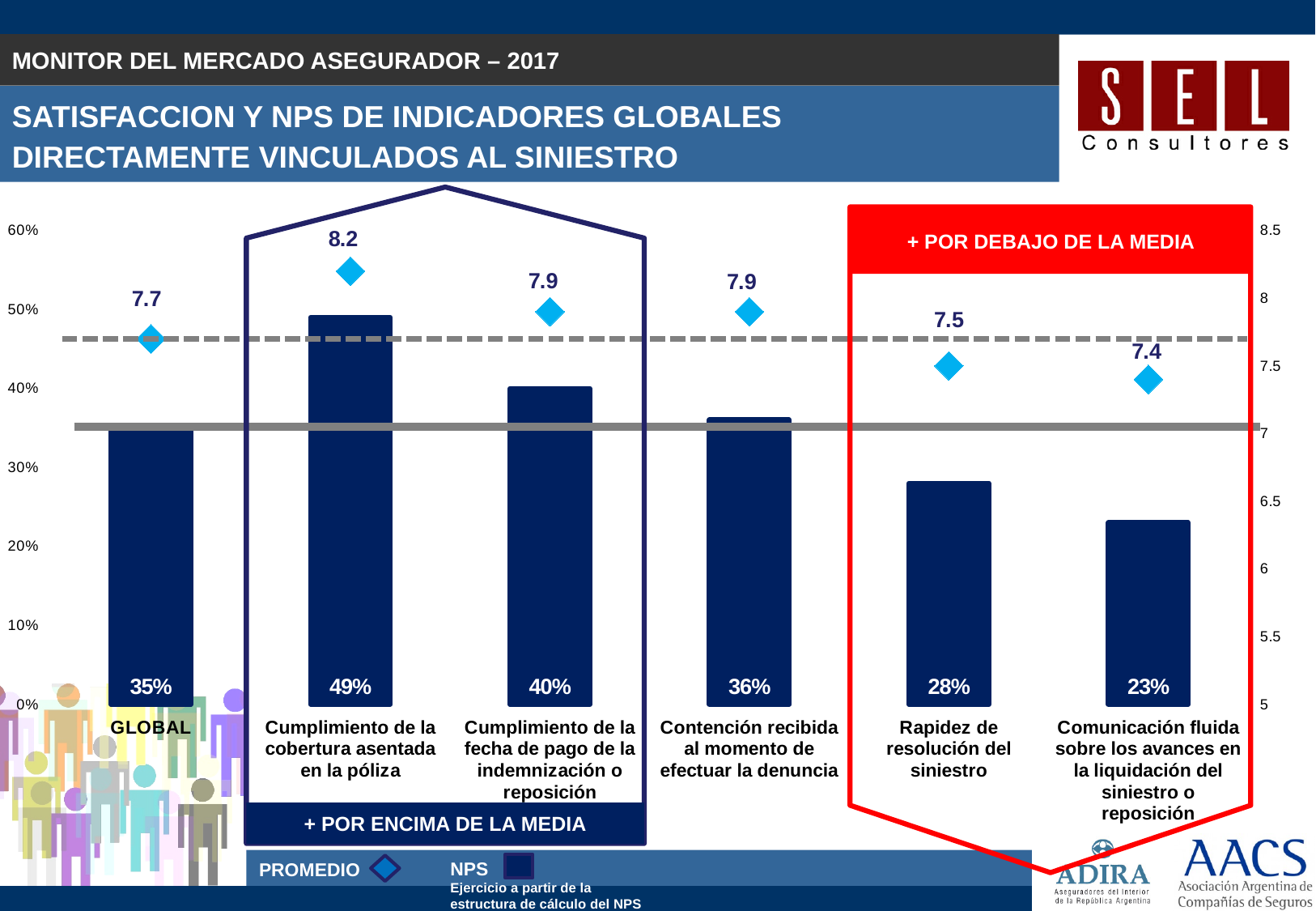
What is the NPS value for GLOBAL? 35% What label is shown in the red box above the two rightmost categories? + POR DEBAJO DE LA MEDIA How many series does the legend list? 2 Which category has the lowest PROMEDIO value? Comunicación fluida sobre los avances en la liquidación del siniestro o reposición What is the PROMEDIO value for Cumplimiento de la cobertura asentada en la póliza? 8.2 Which has a higher NPS: Cumplimiento de la fecha de pago de la indemnización o reposición or Contención recibida al momento de efectuar la denuncia? Cumplimiento de la fecha de pago de la indemnización o reposición What is the NPS value for Rapidez de resolución del siniestro? 28% What is the PROMEDIO value for Comunicación fluida sobre los avances en la liquidación del siniestro o reposición? 7.4 What kind of chart is used to show the NPS values? Bar chart Which category has the highest NPS bar? Cumplimiento de la cobertura asentada en la póliza What is the difference in NPS between Cumplimiento de la cobertura asentada en la póliza and Comunicación fluida sobre los avances en la liquidación del siniestro o reposición? 26% How many categories are shown on the x axis of the chart? 6